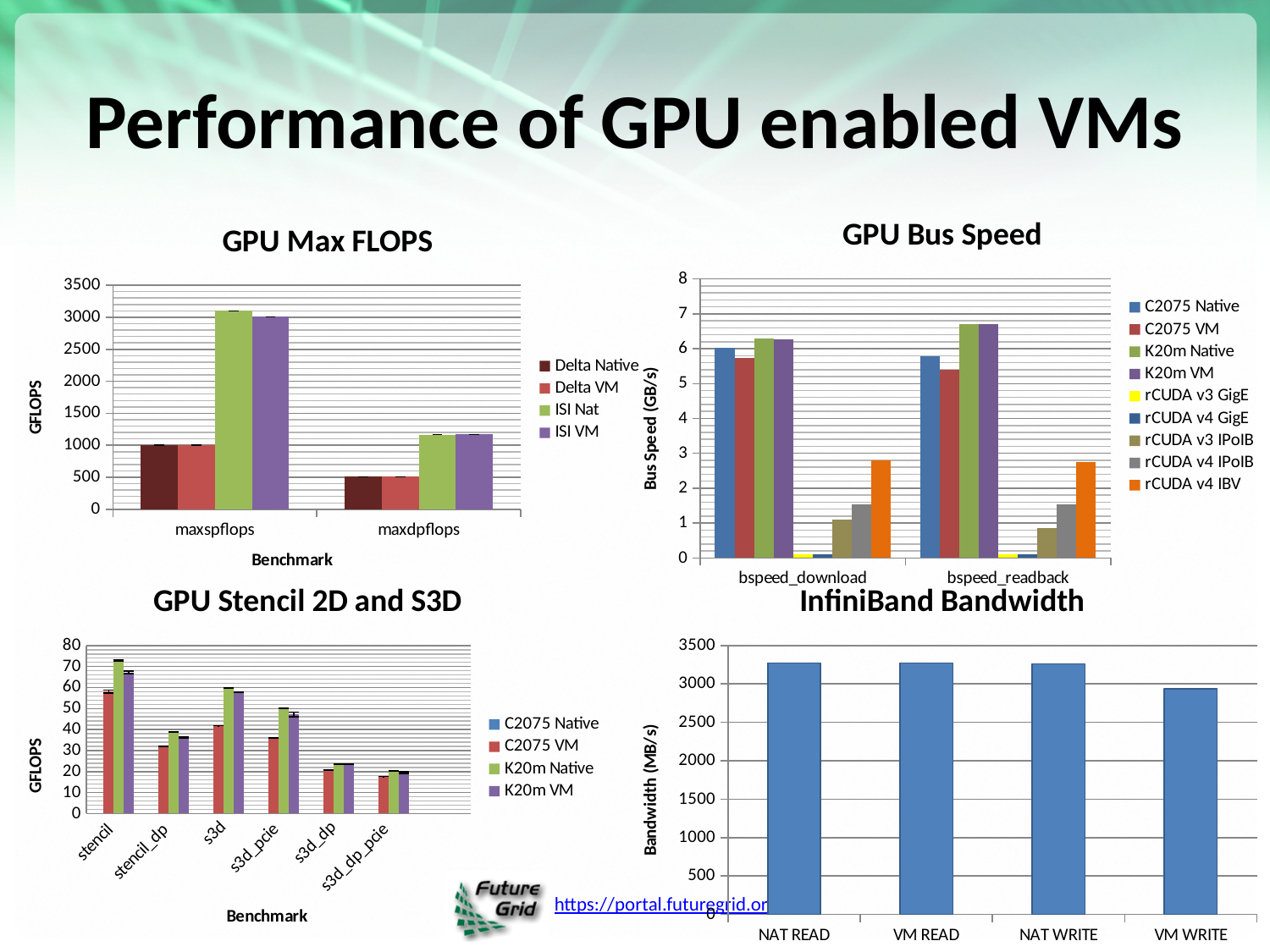
In the GPU Stencil 2D and S3D chart, how many benchmark categories are shown on the x axis? 6 In the GPU Stencil 2D and S3D chart, is the value for K20m Native at stencil greater or less than 70? greater In the GPU Stencil 2D and S3D chart, which benchmark has the lowest values overall? s3d_dp_pcie In the GPU Max FLOPS chart, is the value for ISI Nat at maxspflops greater or less than 3000? greater What kind of chart is the InfiniBand Bandwidth chart? bar chart In the GPU Max FLOPS chart, which is larger at maxspflops: ISI Nat or Delta Native? ISI Nat In the InfiniBand Bandwidth chart, which category has the lowest bandwidth? VM WRITE In the GPU Max FLOPS chart, how many series does the legend list? 4 In the InfiniBand Bandwidth chart, is the value for VM WRITE greater or less than 3000? less In the GPU Bus Speed chart, how many series does the legend list? 9 In the GPU Bus Speed chart, which is larger at bspeed_download: C2075 Native or C2075 VM? C2075 Native